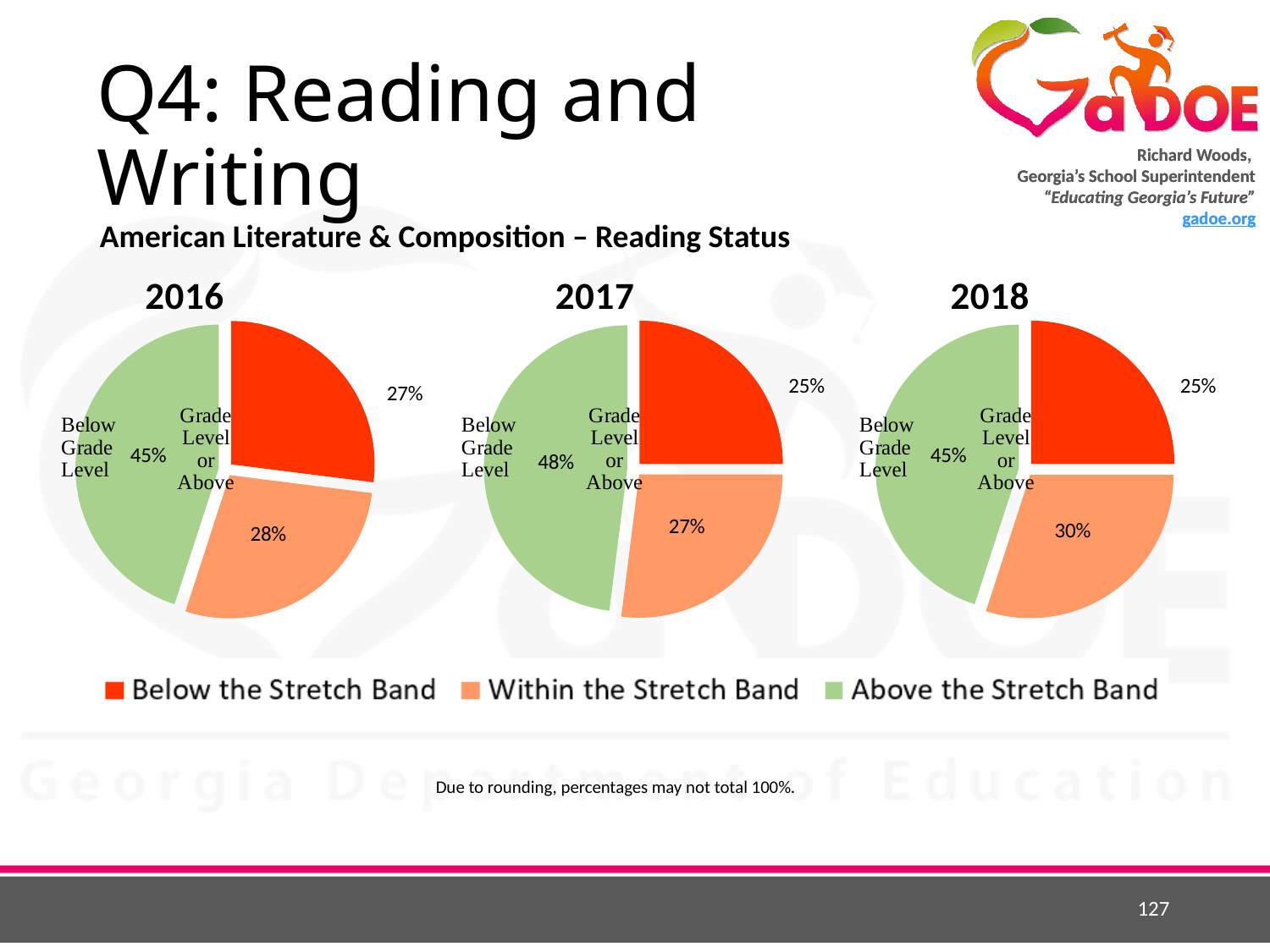
What is the difference between the Above the Stretch Band share in 2017 and in 2016? 3% In the 2016 pie chart, what percentage is Within the Stretch Band? 28% How many pie charts are shown on the slide? 3 In the 2016 pie chart, what percentage is Above the Stretch Band? 45% In the 2017 pie chart, which category has the largest share? Above the Stretch Band What type of chart is used to show the reading status for each year? Pie chart How many categories does the legend list? 3 In the 2017 pie chart, what percentage is Below the Stretch Band? 25% Which colour represents Above the Stretch Band in the legend? Green In the 2018 pie chart, which category has the smallest share? Below the Stretch Band In the 2018 pie chart, what percentage is Within the Stretch Band? 30% Is the Within the Stretch Band share larger in 2018 or in 2016? 2018